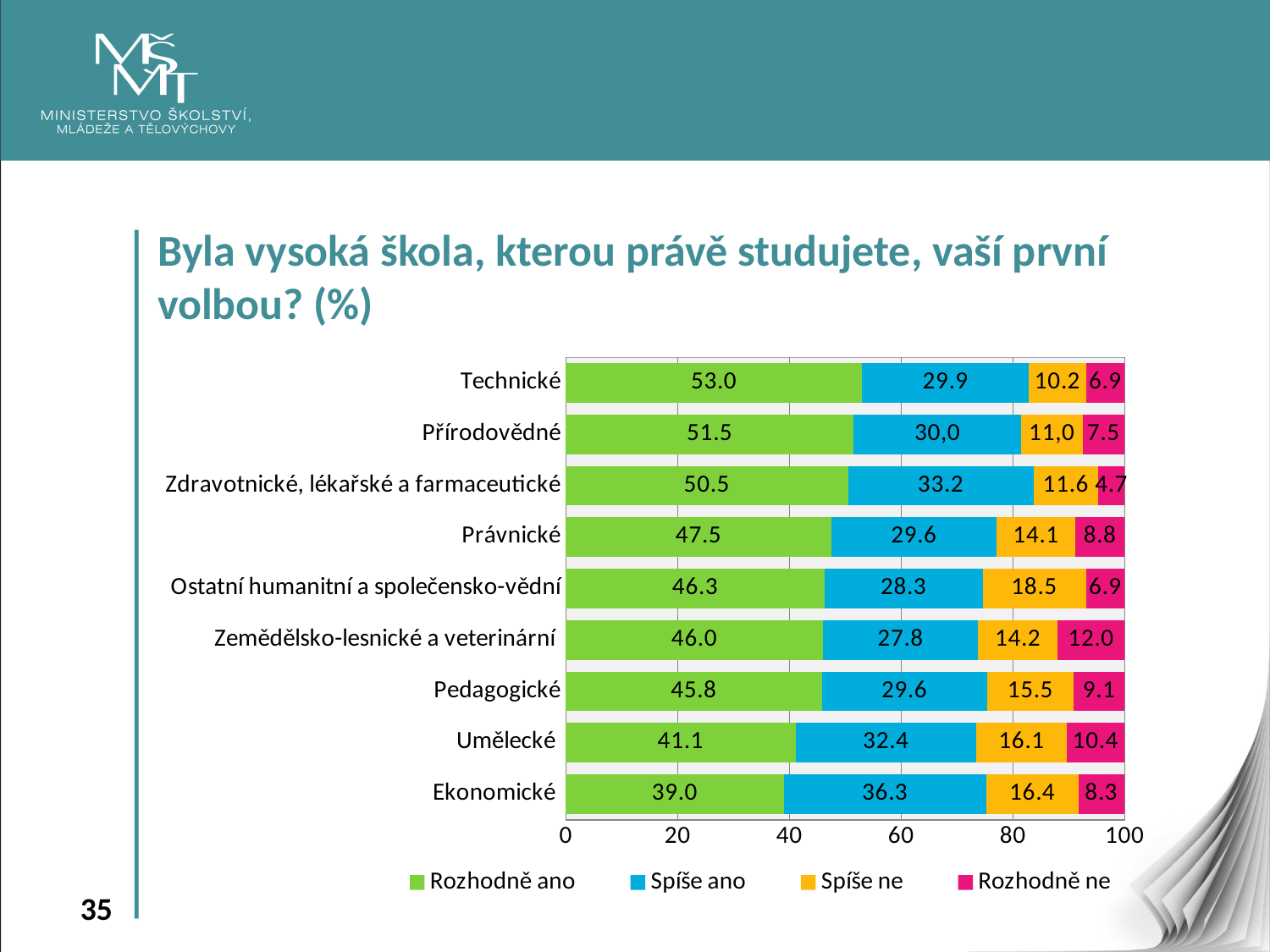
What kind of chart is shown on the slide? Stacked bar chart Which category has the highest value for "Rozhodně ano"? Technické What is the difference between the "Rozhodně ano" values for Technické and Ekonomické? 14.0 How many series does the legend list? 4 Which category has the lowest value for "Rozhodně ne"? Zdravotnické, lékařské a farmaceutické Which category has the lowest value for "Rozhodně ano"? Ekonomické What is the value of "Spíše ne" for Ostatní humanitní a společensko-vědní? 18.5 How many categories are shown on the chart? 9 Which has the larger "Spíše ano" value, Umělecké or Pedagogické? Umělecké What is the value of "Rozhodně ne" for Zemědělsko-lesnické a veterinární? 12.0 What is the value of "Spíše ano" for Ekonomické? 36.3 What is the value of "Rozhodně ano" for Technické? 53.0